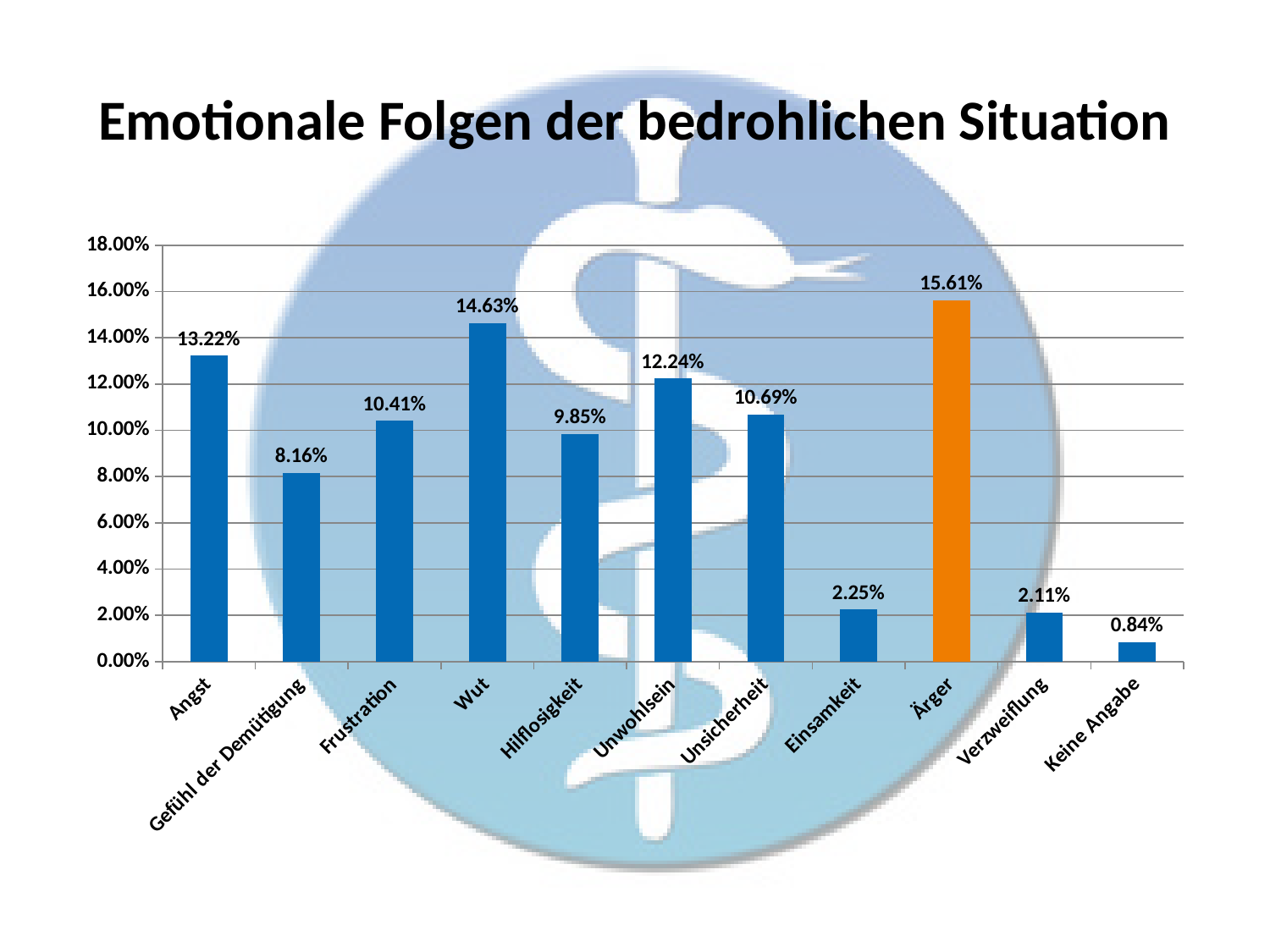
What is the value for Angst? 13.22% What is the title of the chart? Emotionale Folgen der bedrohlichen Situation What is the value for Einsamkeit? 2.25% What kind of chart is shown on the slide? bar chart What is the difference between the values for Ärger and Wut? 0.98% Which category has the highest value? Ärger Is the value for Frustration greater or less than 10.00%? greater Which category's bar is coloured orange instead of blue? Ärger What is the value for Wut? 14.63% Which category has the lowest value? Keine Angabe How many categories are shown on the x axis? 11 Which is larger, the value for Unwohlsein or the value for Unsicherheit? Unwohlsein